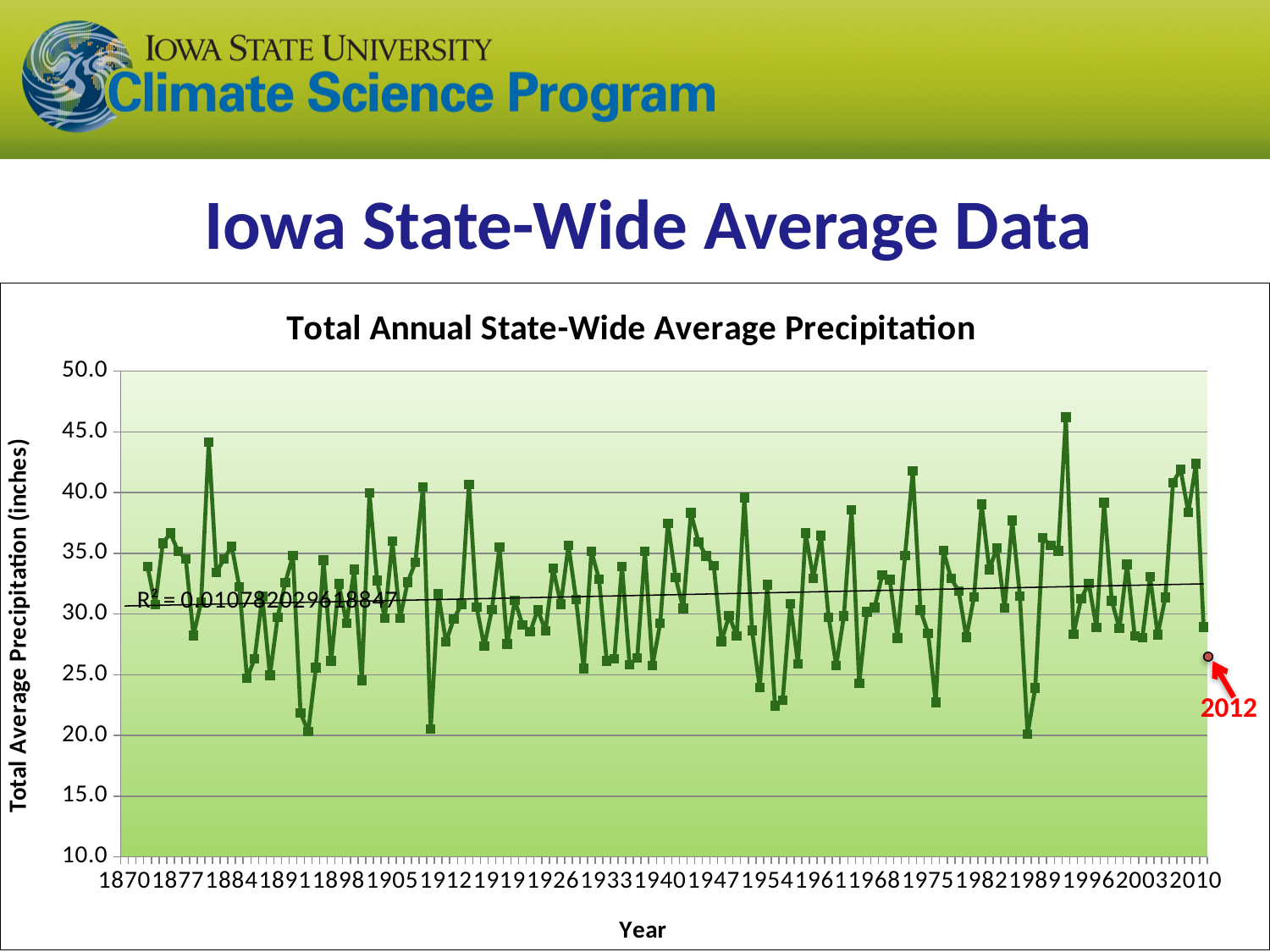
What kind of chart is shown on the slide? line chart Is the value for 2012 greater or less than 25? greater Does the straight trend line drawn through the data slope upward or downward from left to right? upward How many data series are plotted on the chart? 1 Is the lowest value plotted on the chart greater or less than 25? less Is the highest value plotted on the chart greater or less than 45? greater What is the title of the chart? Total Annual State-Wide Average Precipitation